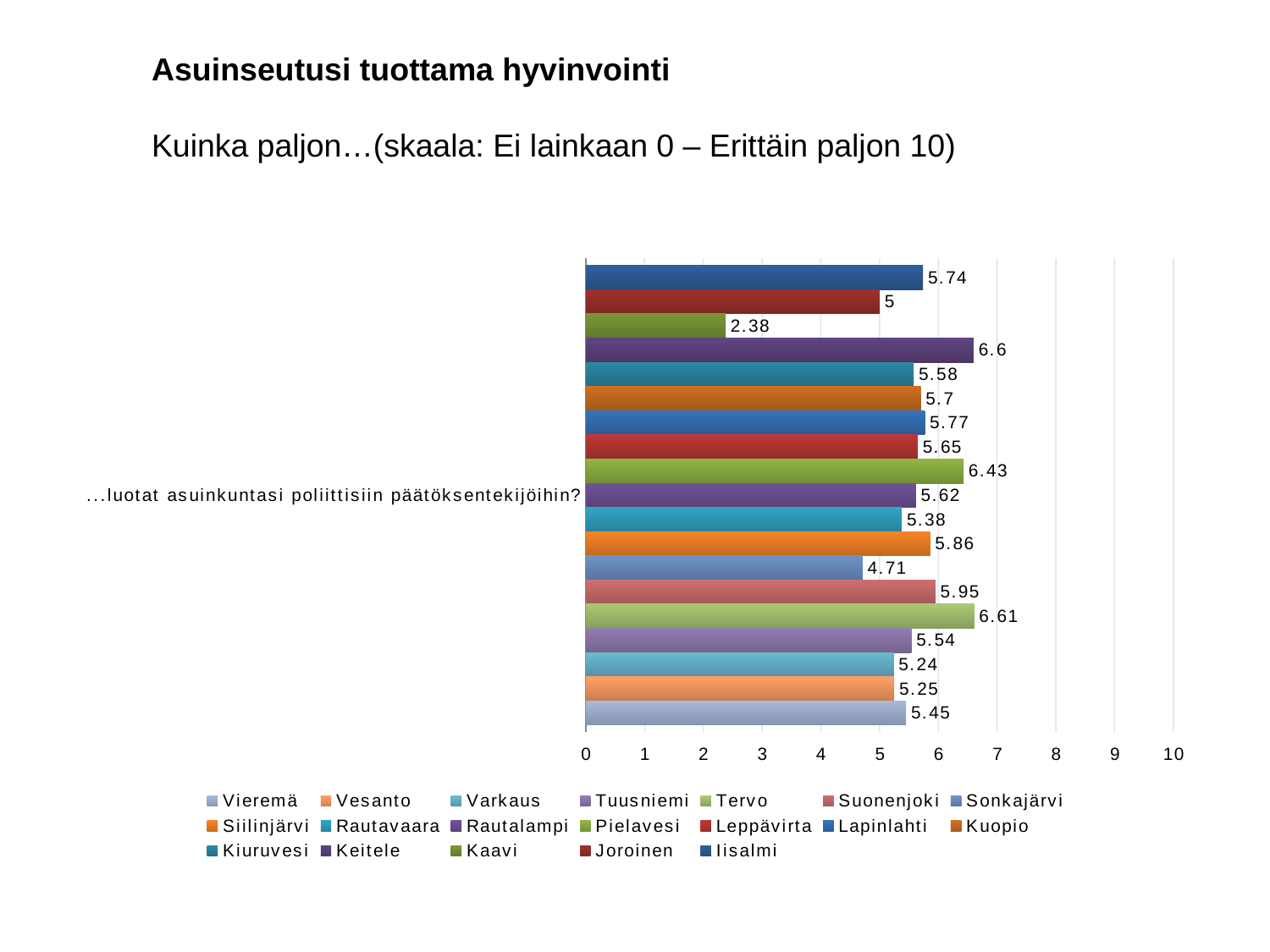
What is the difference between the values for Keitele and Kaavi? 4.22 What is the value for Sonkajärvi? 4.71 What type of chart is shown on the slide? bar chart What is the difference between the values for Siilinjärvi and Sonkajärvi? 1.15 How many series does the legend list? 19 Which municipality has the lowest value? Kaavi What is the value for Joroinen? 5 What is the value for Iisalmi? 5.74 Which is larger, the value for Pielavesi or the value for Suonenjoki? Pielavesi What is the maximum value shown on the horizontal axis? 10 What is the value for Kaavi? 2.38 Is the value for Vieremä greater or less than 5? greater